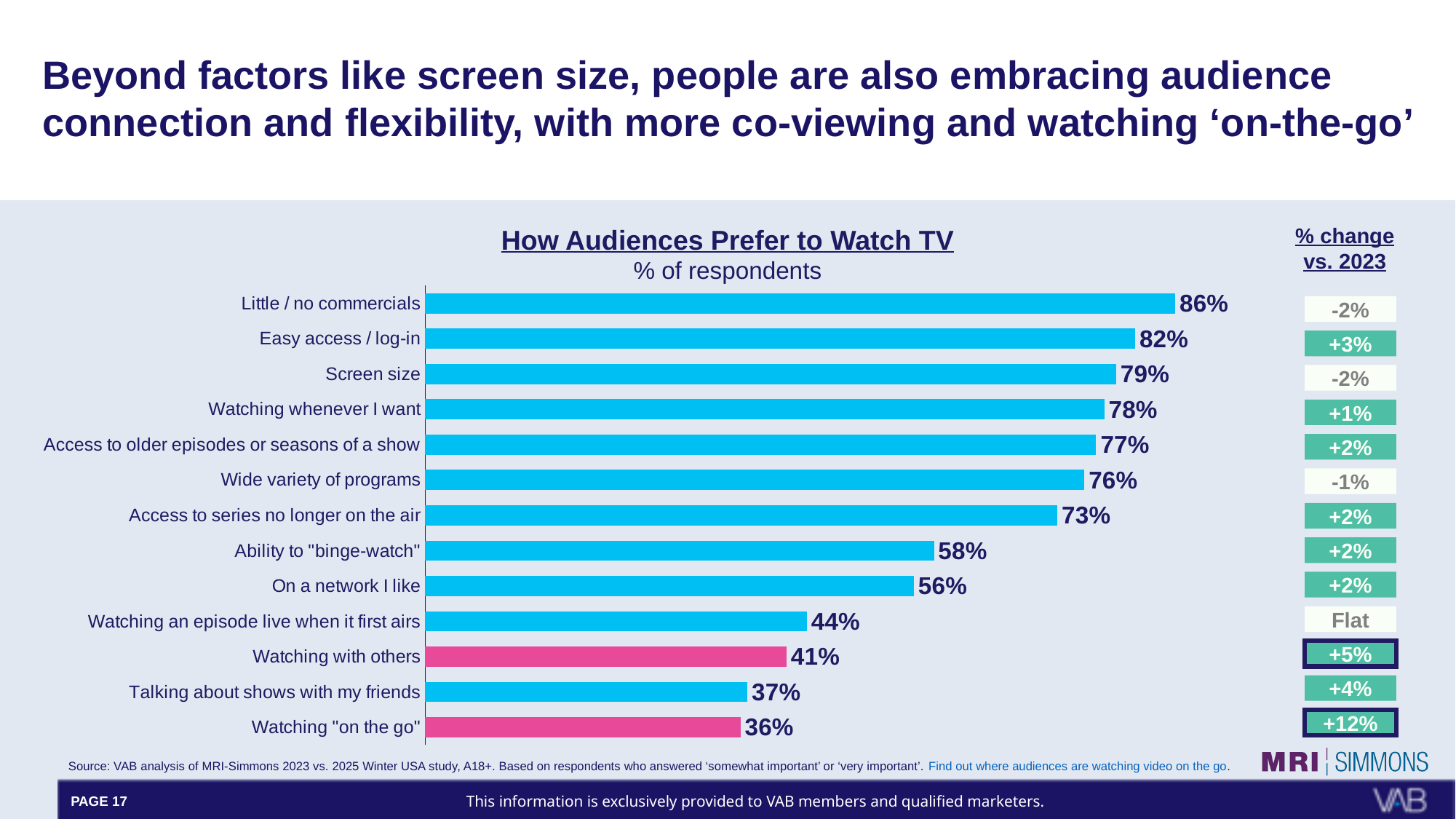
What percentage of respondents prefer 'Little / no commercials'? 86% Which category has the highest percentage of respondents? Little / no commercials How many categories are shown in the bar chart? 13 What percentage of respondents chose 'Ability to "binge-watch"'? 58% What is the difference between 'Screen size' and 'Watching with others'? 38% What type of chart is shown on the slide? Bar chart What is the % change vs. 2023 for 'Watching an episode live when it first airs'? Flat Which is larger: 'On a network I like' or 'Watching an episode live when it first airs'? On a network I like What is the % change vs. 2023 for 'Watching "on the go"'? +12% Which two categories are highlighted with pink bars? Watching with others; Watching "on the go" What is the value for 'Watching "on the go"'? 36% Which category has the lowest percentage of respondents? Watching "on the go"